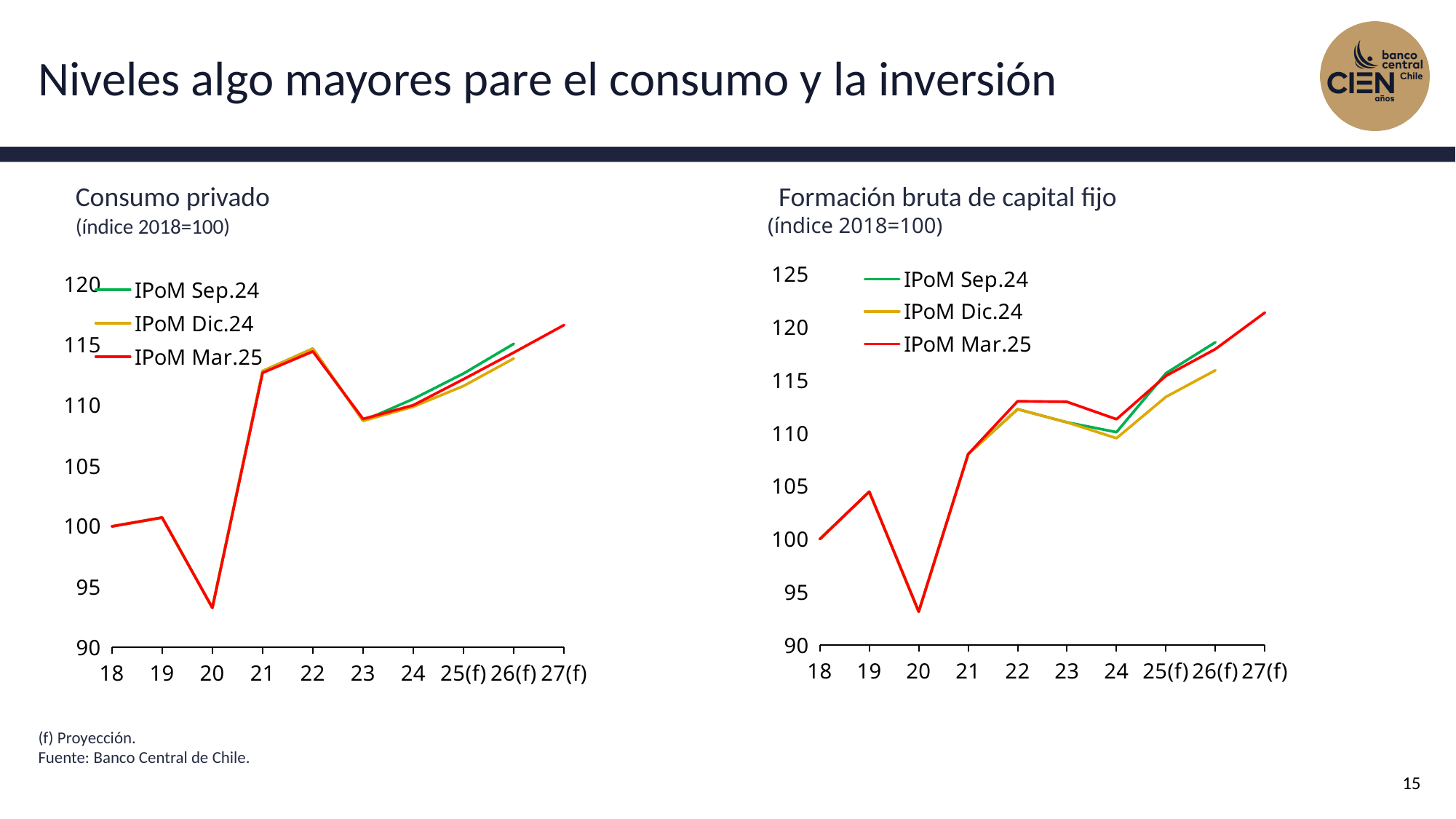
In the 'Consumo privado' chart, what is the value for IPoM Mar.25 in 18? 100 In the 'Consumo privado' chart, which year has the lowest value for IPoM Mar.25? 20 In the 'Consumo privado' chart, does the IPoM Mar.25 line rise or fall from 24 to 27(f)? rise In the 'Formación bruta de capital fijo' chart, which year has the lowest value for IPoM Mar.25? 20 In the 'Formación bruta de capital fijo' chart, is the value for IPoM Mar.25 in 27(f) greater or less than 120? greater In the 'Consumo privado' chart, what kind of chart is shown? line chart In the 'Consumo privado' chart, is the value for IPoM Mar.25 in 20 greater or less than 95? less In the 'Consumo privado' chart, how many points are on the x axis? 10 What is the subtitle shown under the 'Consumo privado' chart title? (índice 2018=100) In the 'Formación bruta de capital fijo' chart, is the value for IPoM Mar.25 in 21 greater or less than 105? greater In the 'Formación bruta de capital fijo' chart, which is larger in 26(f): IPoM Sep.24 or IPoM Dic.24? IPoM Sep.24 In the 'Formación bruta de capital fijo' chart, how many series does the legend list? 3